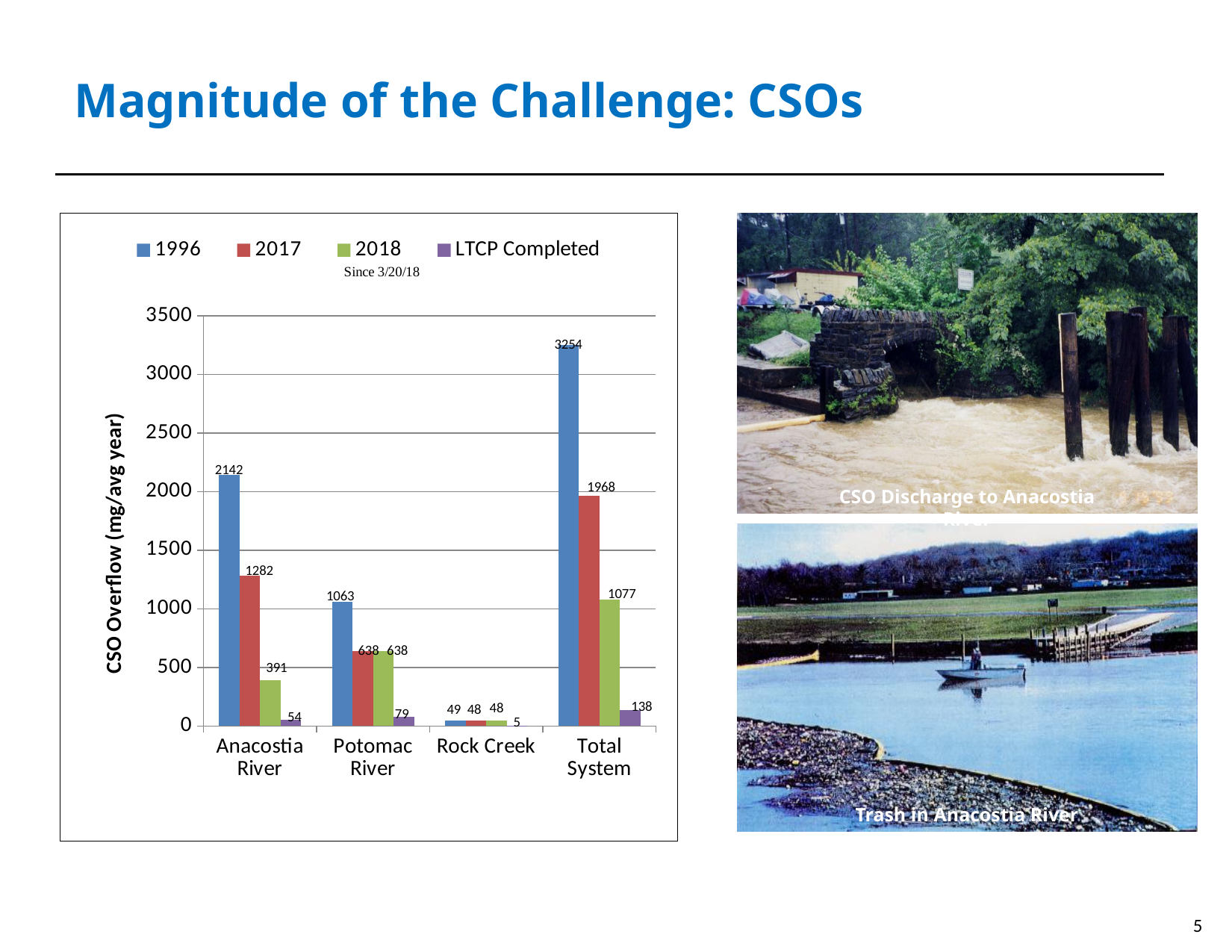
Which category has the highest 1996 value? Total System How many categories are shown on the x axis? 4 Which is larger for the Potomac River: the 1996 value or the 2017 value? 1996 What kind of chart is shown on the slide? Bar chart How many series does the legend list? 4 What is the difference between the 1996 and 2017 values for the Anacostia River? 860 What is the LTCP Completed value for the Total System? 138 What is the 2017 value for Rock Creek? 48 Which river has the lowest LTCP Completed value? Rock Creek What is the 1996 CSO overflow value for the Anacostia River? 2142 What is the label of the y axis? CSO Overflow (mg/avg year) What is the 2018 CSO overflow value for the Potomac River? 638